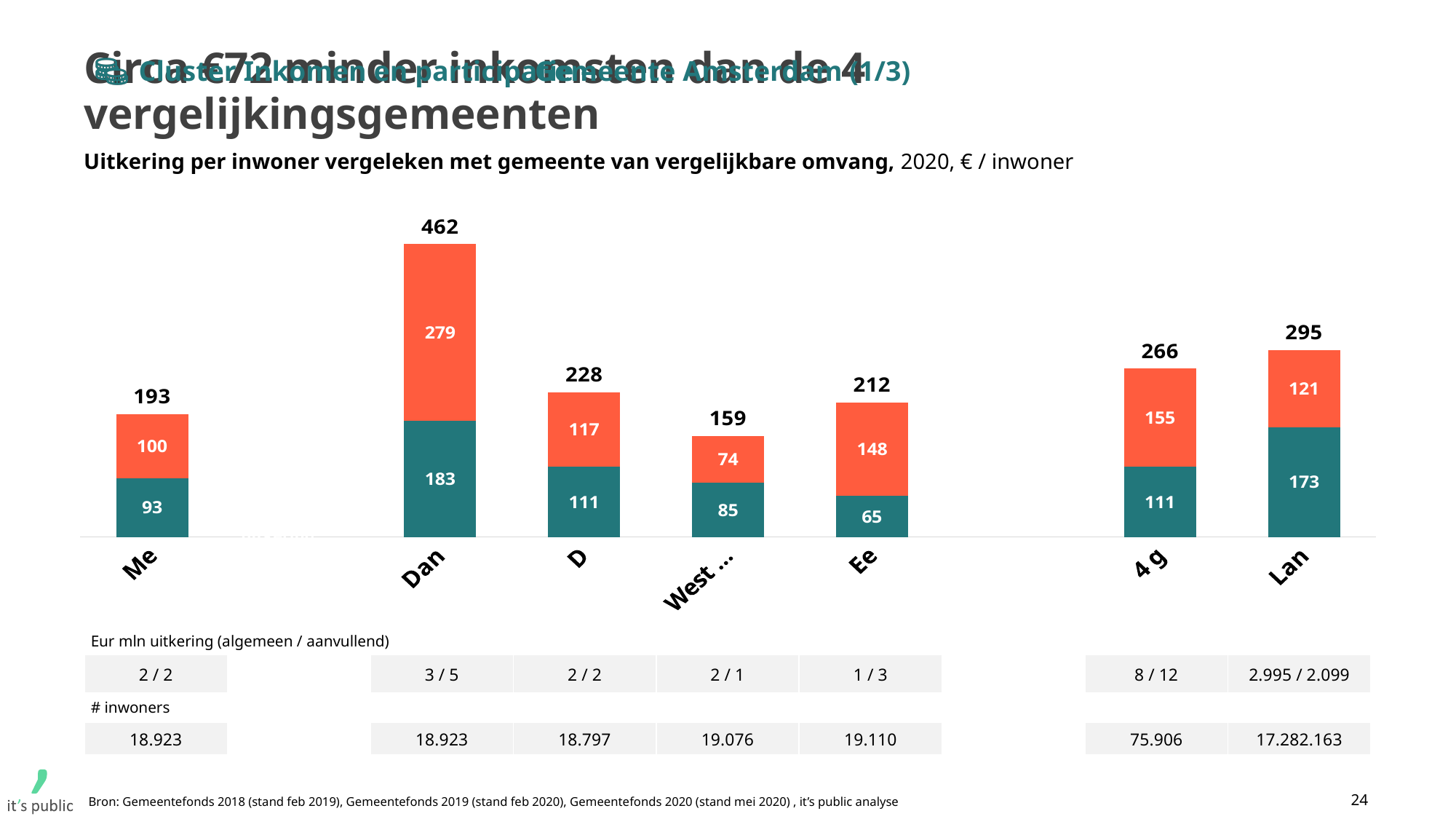
How many bars (categories) are plotted in the chart? 7 What is the difference between the orange segment for Dan and the orange segment for Me? 179 Which has the larger total value, Me or Ee? Ee In what unit are the chart values expressed, according to the subtitle? € / inwoner Which category has the lowest total value in the chart? West ... What is the value of the orange (top) segment for Ee? 148 What is the difference between the total for Lan and the total for 4 g? 29 What kind of chart is shown on the slide? Stacked bar chart What is the total value shown above the bar for Dan? 462 Which category has the highest total value in the chart? Dan What is the value of the teal (bottom) segment for Lan? 173 What is the total value shown above the bar for D? 228